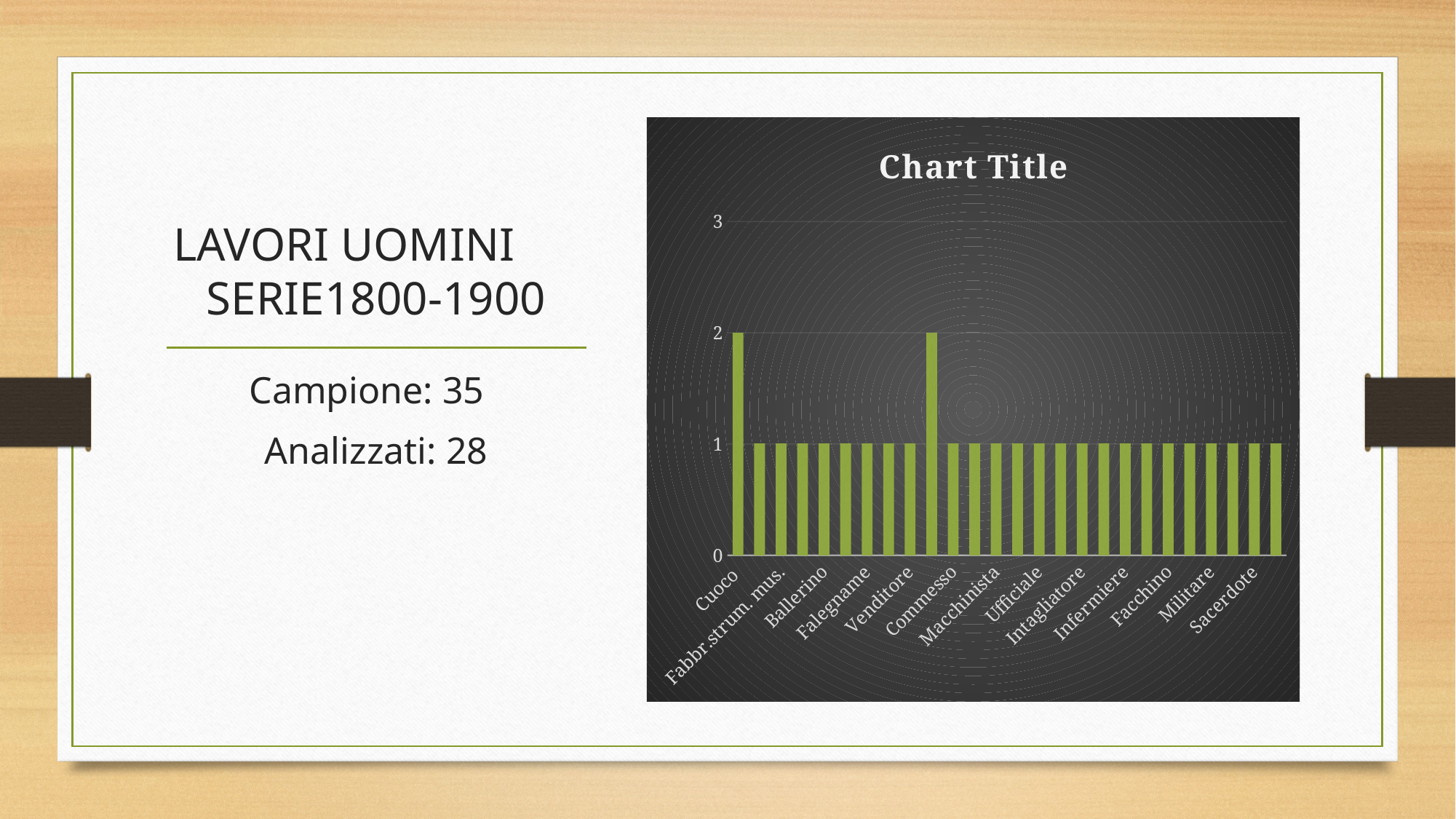
What kind of chart is shown on the slide? bar chart Which is larger, the value for Cuoco or the value for Sacerdote? Cuoco What is the difference between the value for Cuoco and the value for Sacerdote? 1 Is the value for Cuoco greater or less than 1? greater What is the title of the chart? Chart Title What is the highest value shown on the vertical axis? 3 What is the value for Sacerdote? 1 Is the value for Infermiere greater or less than 2? less What colour are the bars in the chart? green What is the value for Cuoco? 2 What is the value for Militare? 1 What is the value for Facchino? 1